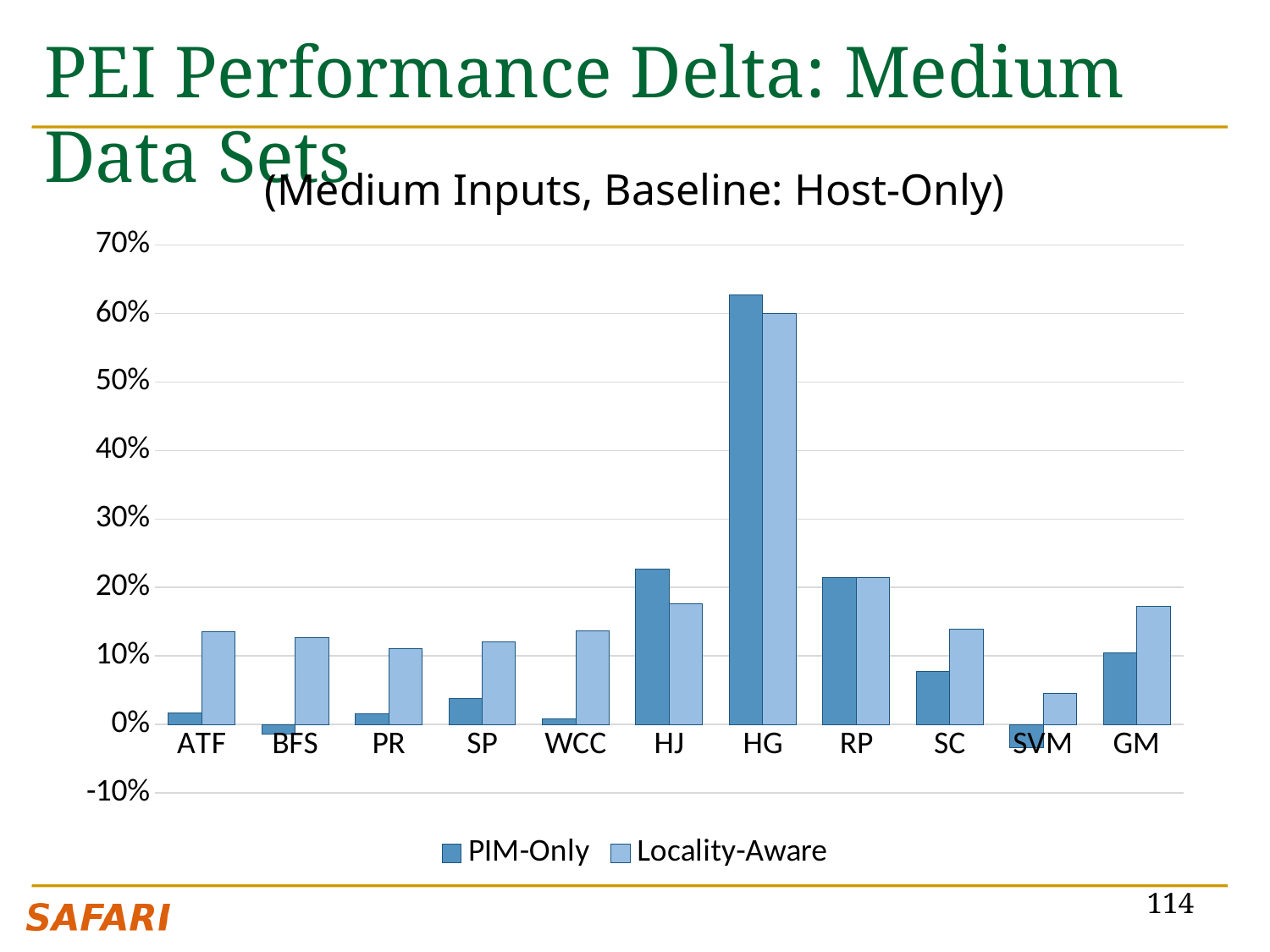
How many series does the legend list? 2 Which category has the lowest Locality-Aware value? SVM Is the PIM-Only value for SC greater or less than 10%? less Is the PIM-Only value for HG greater or less than 60%? greater Is the Locality-Aware value for ATF greater or less than 10%? greater What are the two series named in the legend? PIM-Only and Locality-Aware How many categories are shown on the x axis? 11 Which category has the highest PIM-Only value? HG For HJ, which series has the larger value, PIM-Only or Locality-Aware? PIM-Only Which category has the highest Locality-Aware value? HG What kind of chart is shown on the slide? bar chart For ATF, which series has the larger value, PIM-Only or Locality-Aware? Locality-Aware